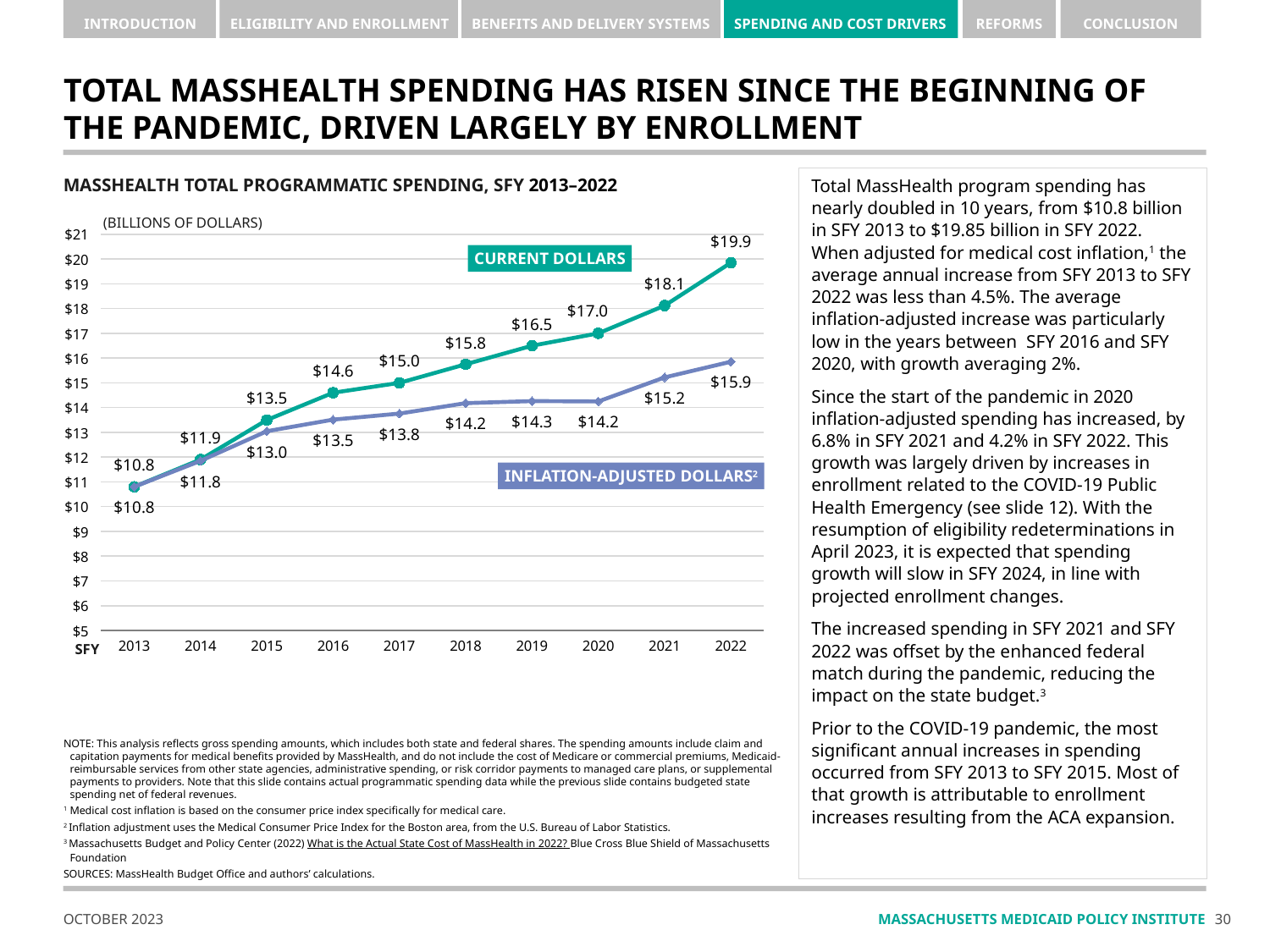
Which is larger in 2020: current-dollar spending or inflation-adjusted spending? Current-dollar spending What kind of chart is shown on the slide? Line chart What was the inflation-adjusted spending value for 2019? $14.3 Does current-dollar spending rise or fall from 2013 to 2022? Rise Which year has the lowest inflation-adjusted spending? 2013 How many years are plotted on the x axis? 10 What was spending in current dollars in 2016? $14.6 What was MassHealth total programmatic spending in current dollars in SFY 2022? $19.9 How many data series does the chart show? 2 By how much did current-dollar spending increase from 2013 to 2022? $9.1 What is the difference between current-dollar and inflation-adjusted spending in 2022? $4.0 Which year has the highest current-dollar spending? 2022